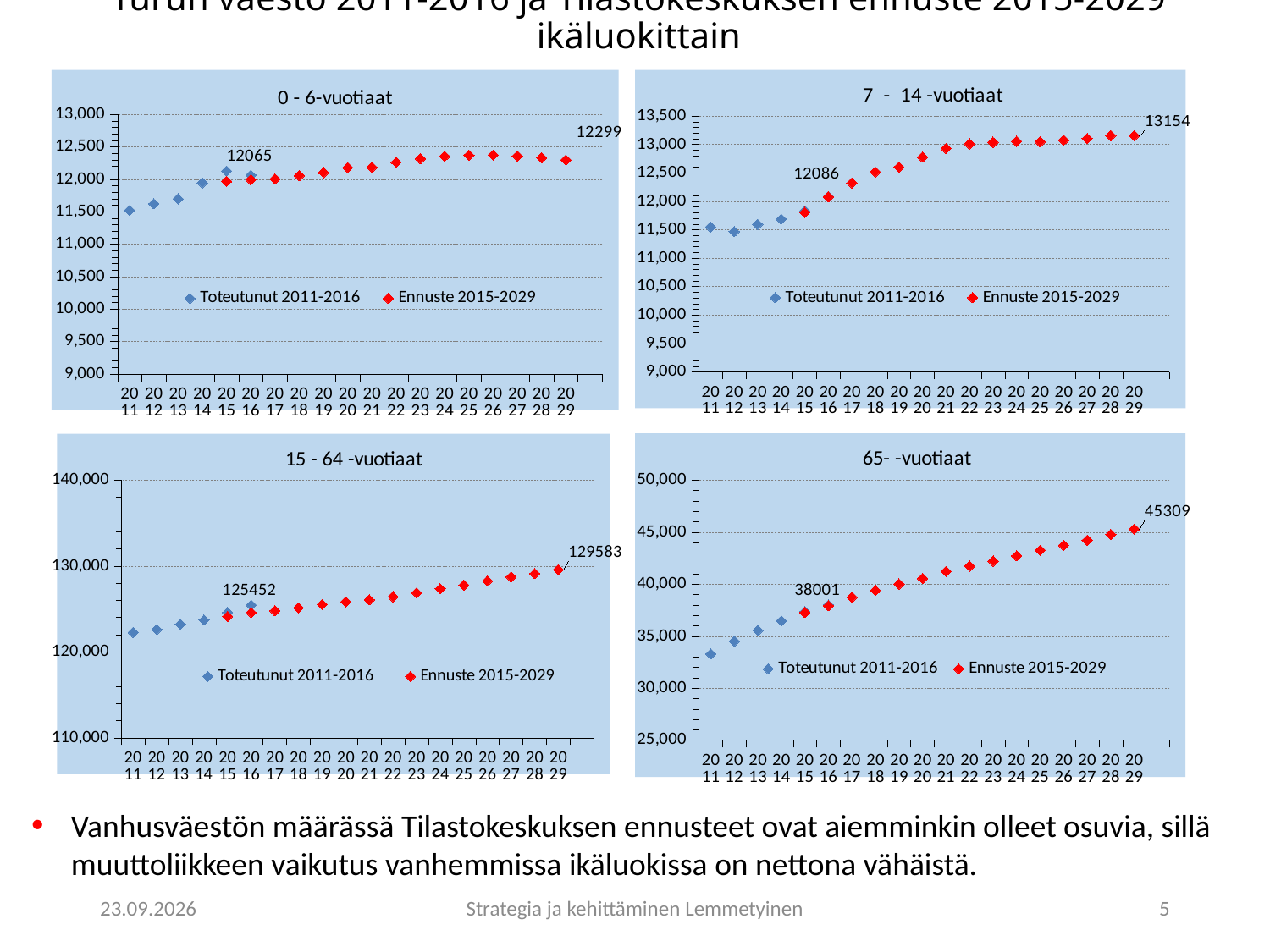
On the '15 - 64 -vuotiaat' chart, is the value for 2011 greater or less than 120,000? greater On the '15 - 64 -vuotiaat' chart, what value is labelled for the 2029 point? 129583 How many series does the legend of the '0 - 6-vuotiaat' chart list? 2 On the '7 - 14 -vuotiaat' chart, what value is labelled for the 2029 point? 13154 On the '65- -vuotiaat' chart, what is the earlier of the two data labels shown (near the 2015 point)? 38001 On the '65- -vuotiaat' chart, do the values rise or fall from 2011 to 2029? rise On the '65- -vuotiaat' chart, is the value for 2011 greater or less than 35,000? less On the '0 - 6-vuotiaat' chart, what value is labelled for the last forecast point in 2029? 12299 On the '15 - 64 -vuotiaat' chart, what is the difference between the labelled values 129583 and 125452? 4131 On the '65- -vuotiaat' chart, what value is labelled for the 2029 point? 45309 On the '65- -vuotiaat' chart, what is the difference between the two labelled values, 45309 and 38001? 7308 How many years are shown on the x axis of the '7 - 14 -vuotiaat' chart? 19